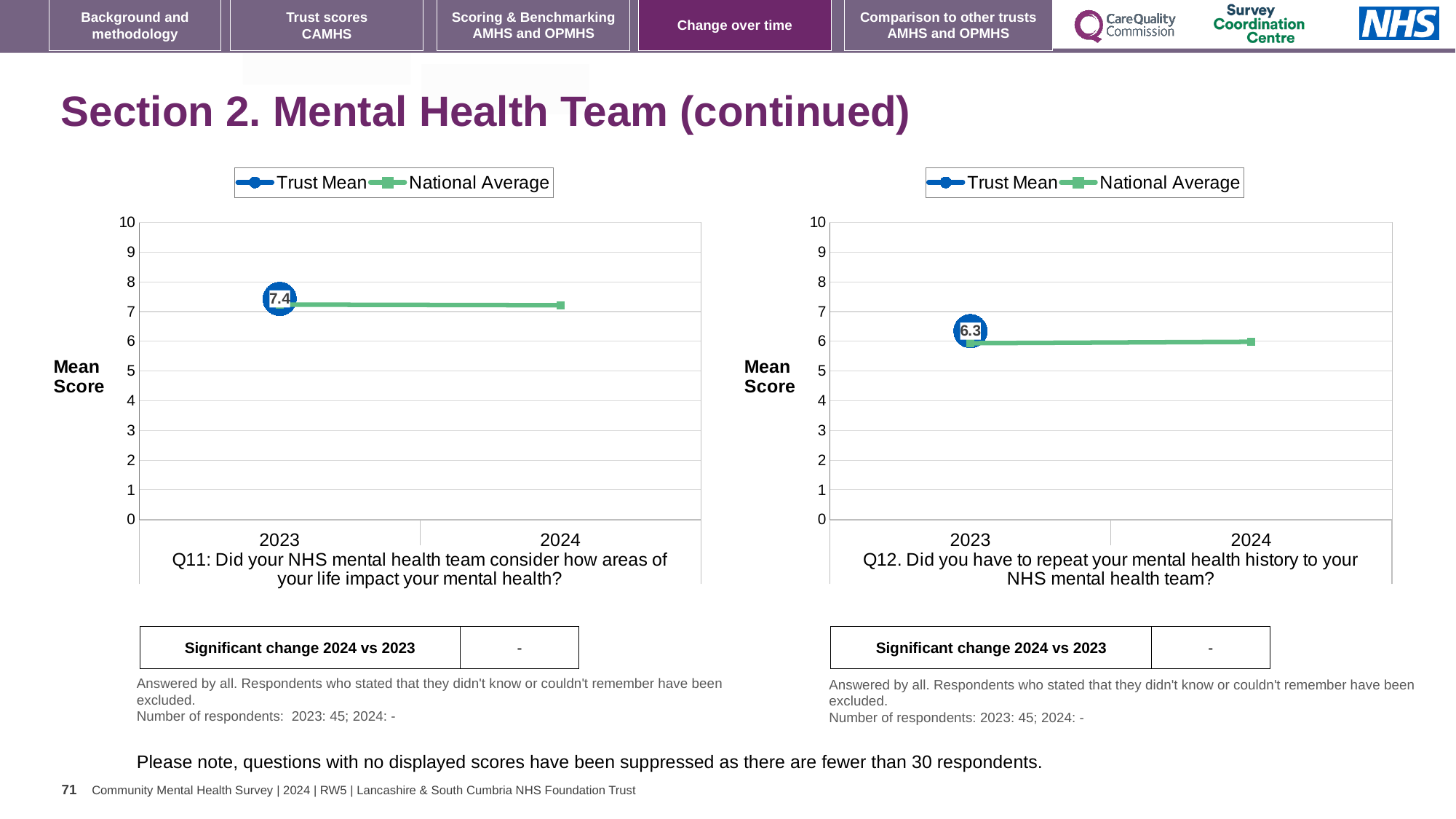
What kind of chart is the right chart (Q12)? Line chart How many series does the legend of the left chart (Q11) list? 2 What is the difference between the 2023 Trust Mean in the left chart (Q11) and the 2023 Trust Mean in the right chart (Q12)? 1.1 In the left chart (Q11), is the National Average value for 2024 greater or less than 5? greater In the right chart (Q12), is the National Average value for 2023 greater or less than 4? greater What is the y-axis label of the left chart (Q11)? Mean Score In the left chart (Q11), what is the Trust Mean score for 2023? 7.4 Which is larger: the 2023 Trust Mean in the left chart (Q11) or the 2023 Trust Mean in the right chart (Q12)? Left chart (Q11), 7.4 What are the two legend entries shown for the right chart (Q12)? Trust Mean and National Average In the right chart (Q12), what is the Trust Mean score for 2023? 6.3 How many years are shown on the x axis of the left chart (Q11)? 2 In the right chart (Q12), is the National Average value for 2024 greater or less than 7? less